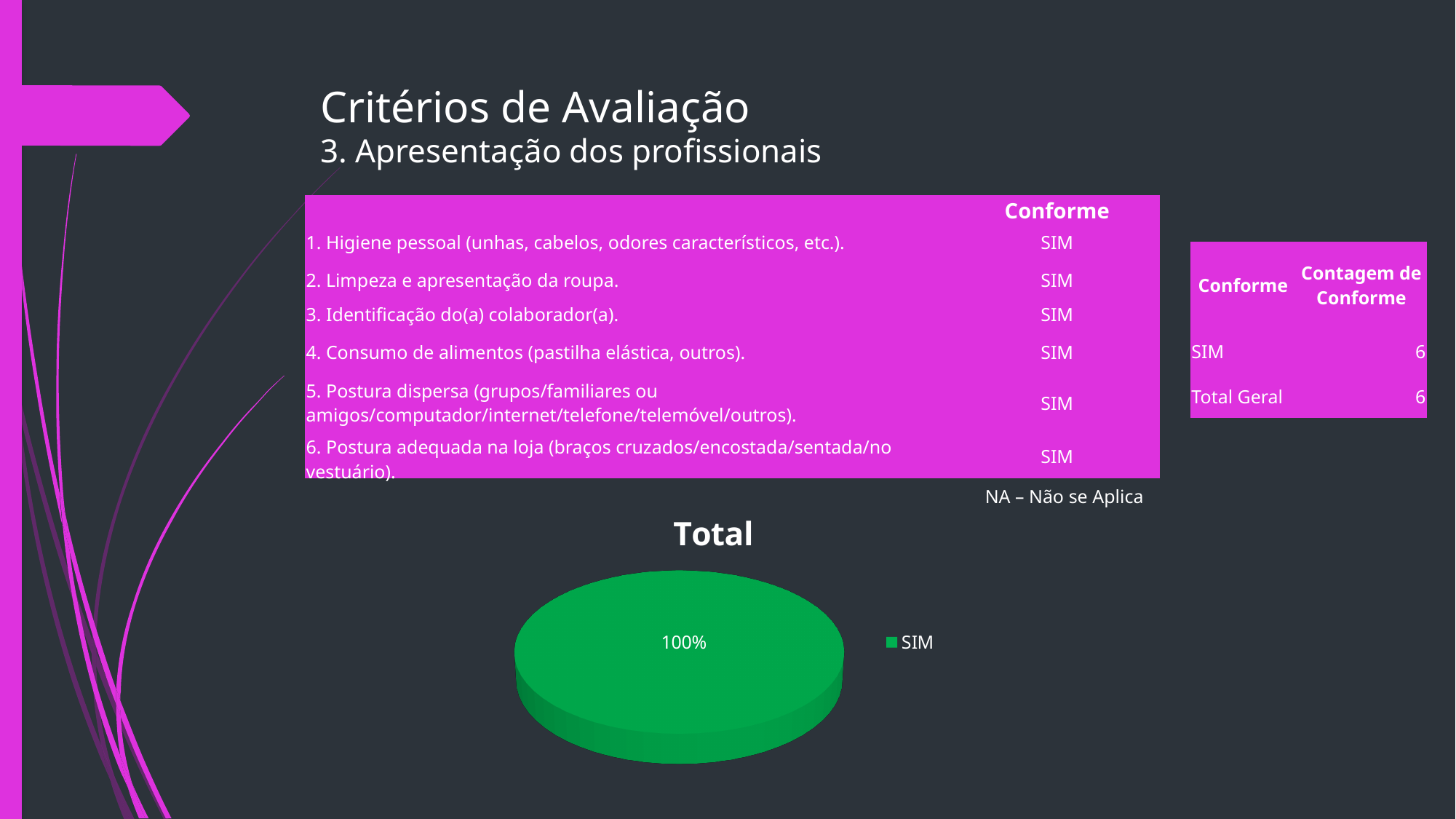
What is the data label printed on the pie chart's slice? 100% How many slices does the pie chart have? 1 How many entries does the legend of the pie chart list? 1 What kind of chart is shown under the title "Total"? pie chart What is the legend entry shown next to the pie chart? SIM What is the title of the pie chart? Total What share of the pie chart does the SIM slice represent? 100%